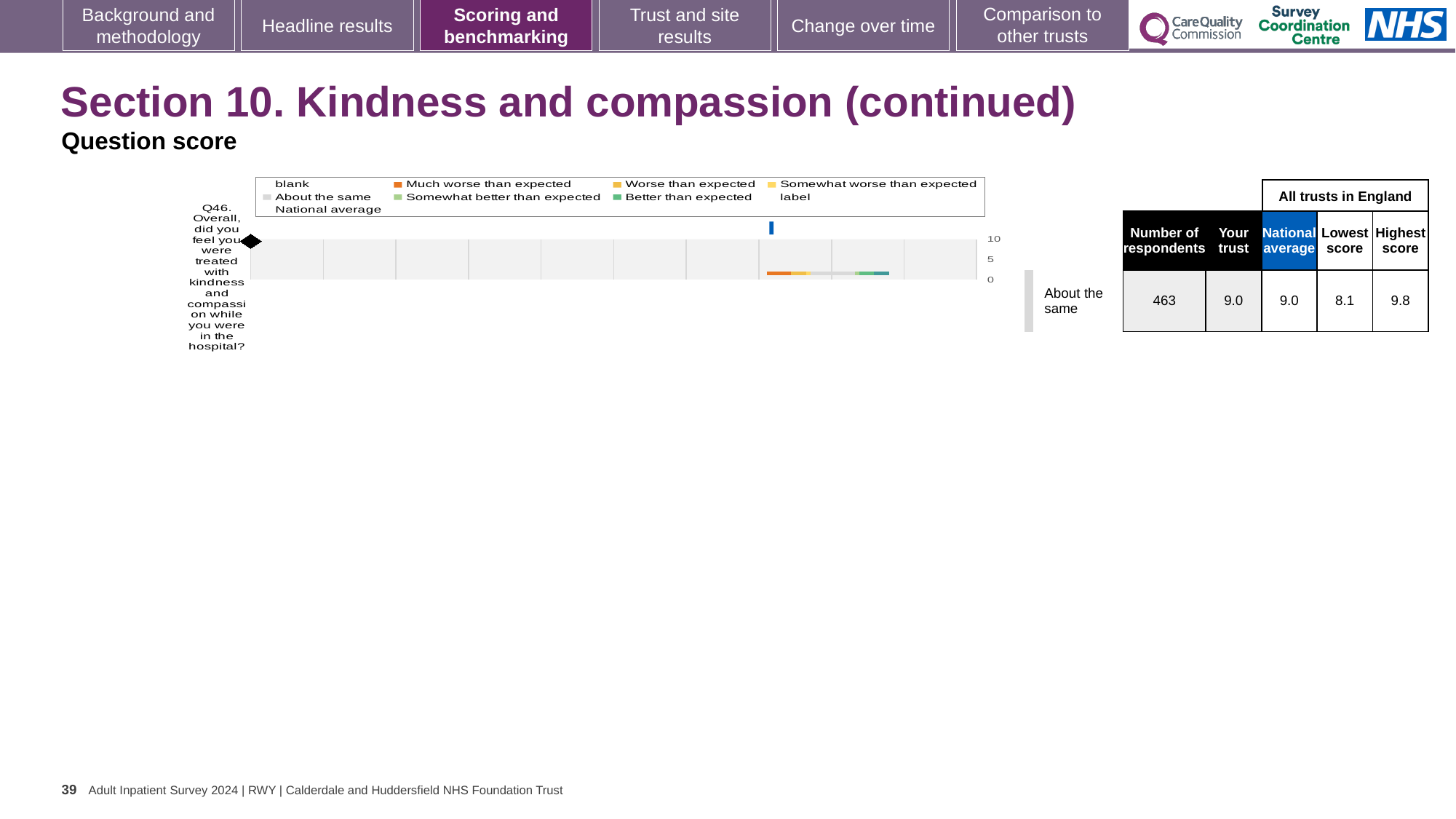
What benchmarking category is the trust's Q46 score placed in? About the same How many questions (categories) are plotted in the chart? 1 In the table beside the chart, what is the Lowest score among all trusts in England for Q46? 8.1 How many respondents answered Q46 according to the table beside the chart? 463 Which is larger for Q46, the Highest score or the Your trust score? Highest score In the table beside the chart, what is the National average score for Q46? 9.0 In the table beside the chart, what is the Highest score among all trusts in England for Q46? 9.8 What kind of chart is shown for Q46 on this slide? bar chart What is the difference between the Highest score and the Lowest score for Q46 in the table beside the chart? 1.7 Which question is plotted in the chart? Q46. Overall, did you feel you were treated with kindness and compassion while you were in the hospital? In the table beside the chart, what is the 'Your trust' score for Q46? 9.0 What is the highest tick value shown on the chart's score axis? 10